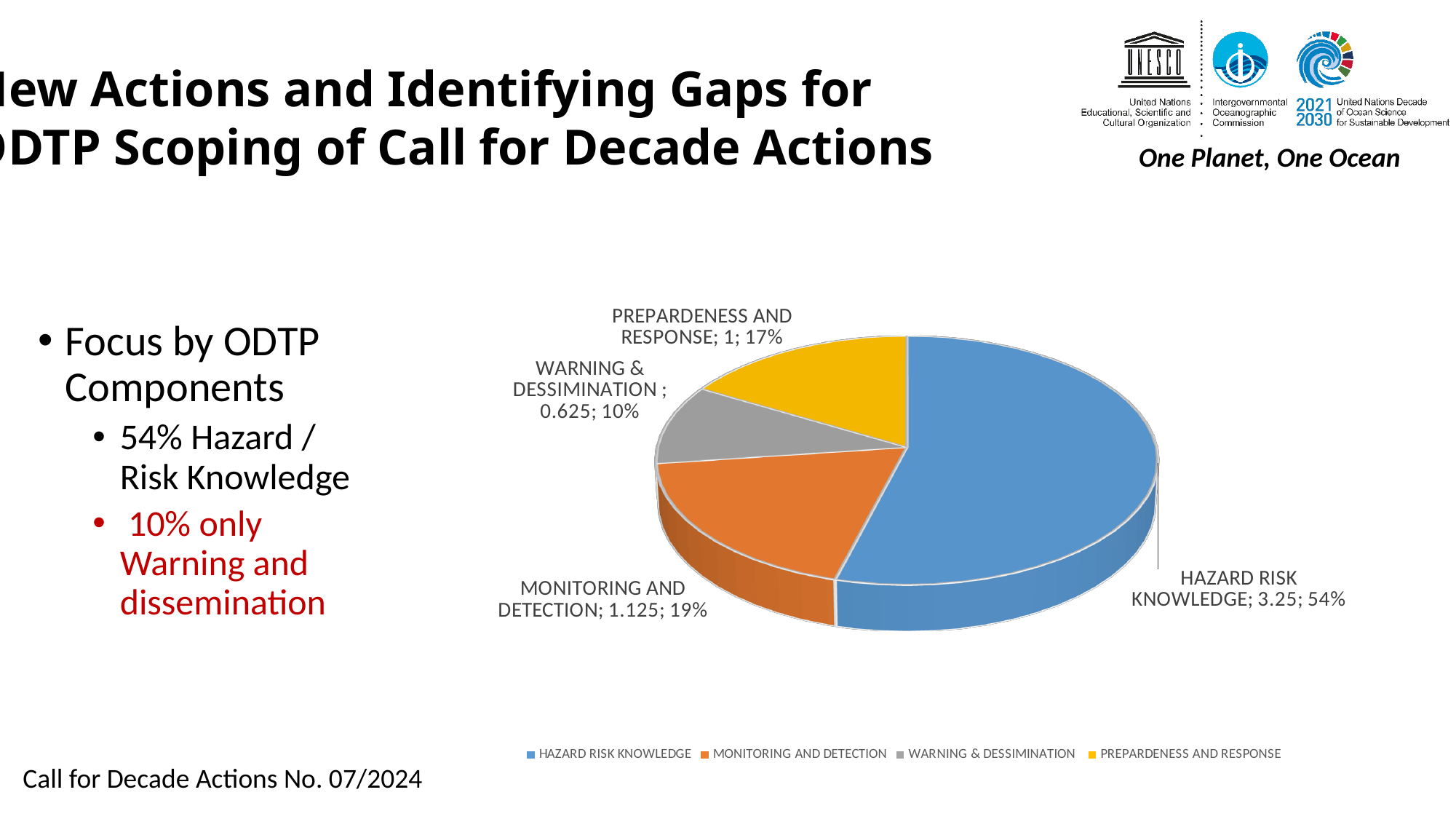
Which is larger in the pie chart, MONITORING AND DETECTION or PREPARDENESS AND RESPONSE? MONITORING AND DETECTION How many slices does the pie chart have? 4 What percentage share does PREPARDENESS AND RESPONSE have in the pie chart? 17% What is the difference between the values for HAZARD RISK KNOWLEDGE and MONITORING AND DETECTION? 2.125 What colour is the HAZARD RISK KNOWLEDGE slice in the pie chart? Blue What kind of chart is shown on the slide? Pie chart What percentage share does MONITORING AND DETECTION have in the pie chart? 19% Which category has the smallest slice in the pie chart? WARNING & DESSIMINATION Which category has the largest slice in the pie chart? HAZARD RISK KNOWLEDGE How many entries does the pie chart's legend list? 4 What value is shown for WARNING & DESSIMINATION in the pie chart? 0.625 What value is shown for HAZARD RISK KNOWLEDGE in the pie chart? 3.25